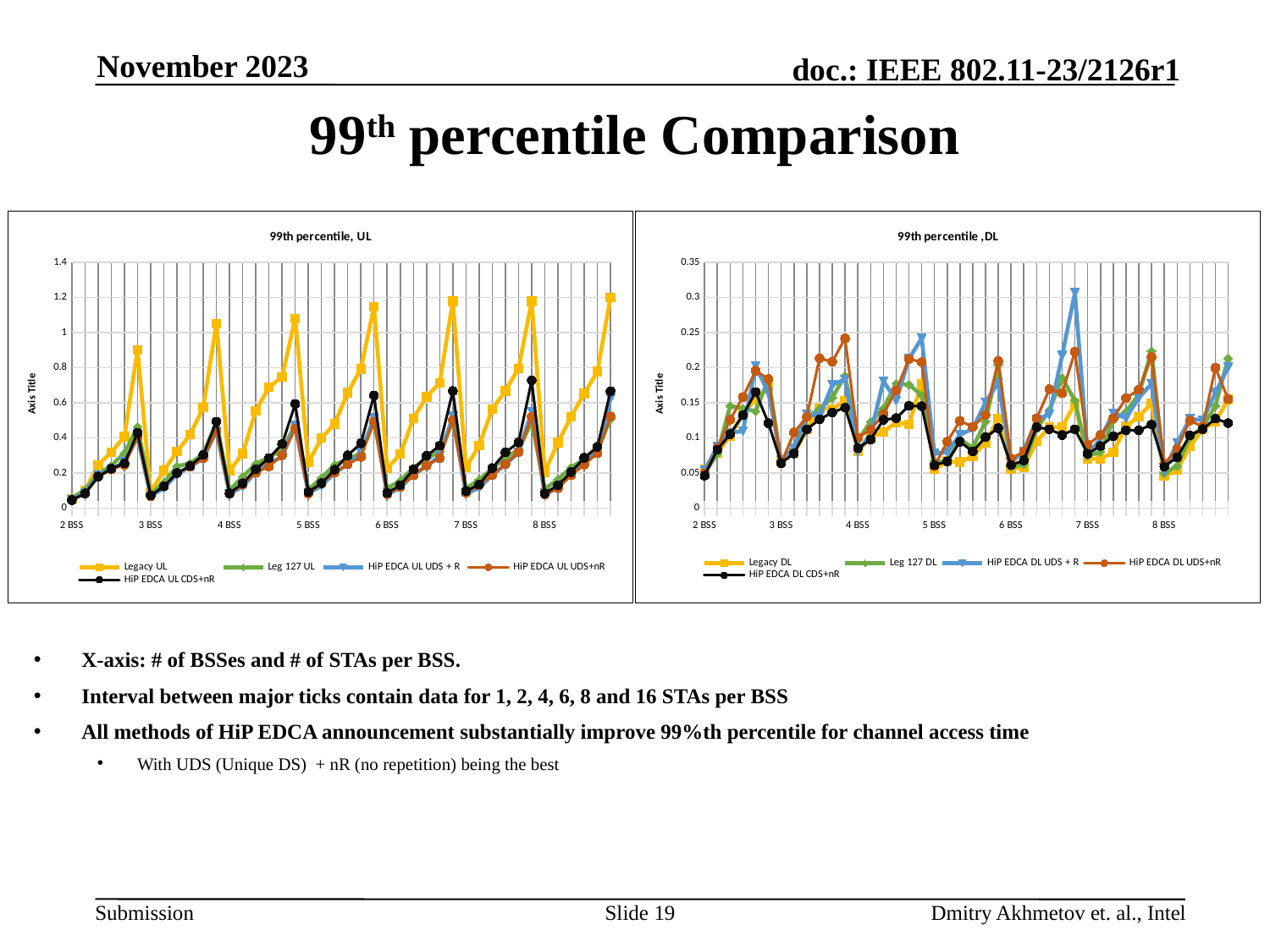
In the right chart (99th percentile ,DL), what is the maximum value shown on the y axis? 0.35 In the right chart (99th percentile ,DL), how many series does the legend list? 5 What kind of chart is the right chart titled "99th percentile ,DL"? line chart In the right chart (99th percentile ,DL), is the highest point of the Legacy DL series greater or less than 0.25? less In the right chart (99th percentile ,DL), is the highest point of the HiP EDCA DL UDS + R series greater or less than 0.25? greater In the left chart (99th percentile, UL), is the highest point of the Legacy UL series greater or less than 1? greater In the left chart (99th percentile, UL), what is the first x-axis label? 2 BSS In the left chart (99th percentile, UL), how many BSS groups are labelled on the x axis? 7 In the left chart (99th percentile, UL), how many series does the legend list? 5 In the left chart (99th percentile, UL), what is the maximum value shown on the y axis? 1.4 What kind of chart is the left chart titled "99th percentile, UL"? line chart In the left chart (99th percentile, UL), which series reaches the highest values overall? Legacy UL